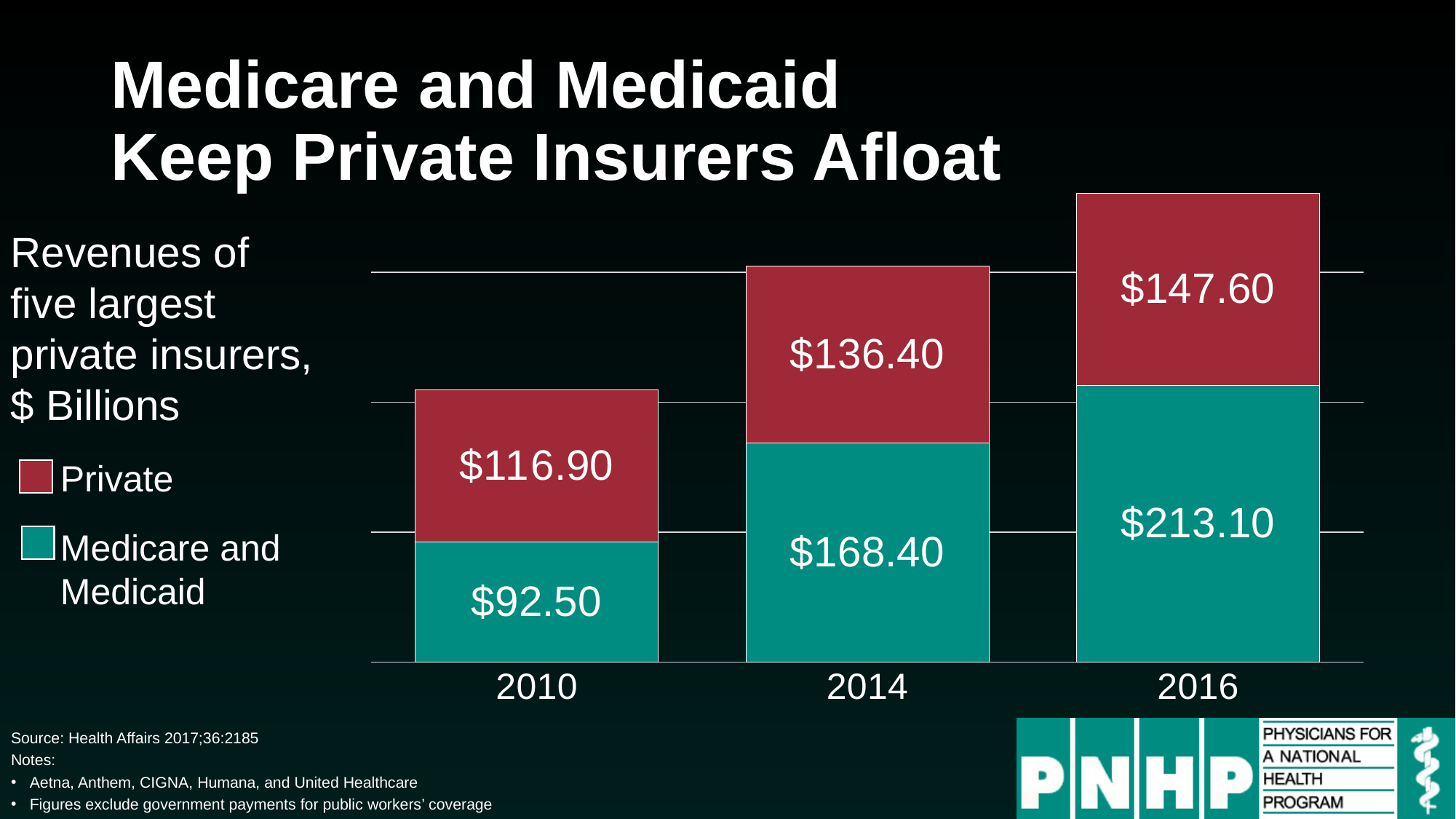
In which year is the Medicare and Medicaid revenue lowest? 2010 What is the Medicare and Medicaid revenue for 2016? $213.10 In 2010, which is larger: Private revenue or Medicare and Medicaid revenue? Private How many years are shown on the x axis? 3 What is the Private revenue for 2010? $116.90 In 2014, which is larger: Private revenue or Medicare and Medicaid revenue? Medicare and Medicaid What is the total revenue shown for 2016? $360.70 What kind of chart is shown on the slide? Stacked bar chart How many series does the legend list? 2 What is the Medicare and Medicaid revenue for 2014? $168.40 In which year is the Private revenue highest? 2016 What is the difference between the Medicare and Medicaid revenue in 2016 and in 2010? $120.60